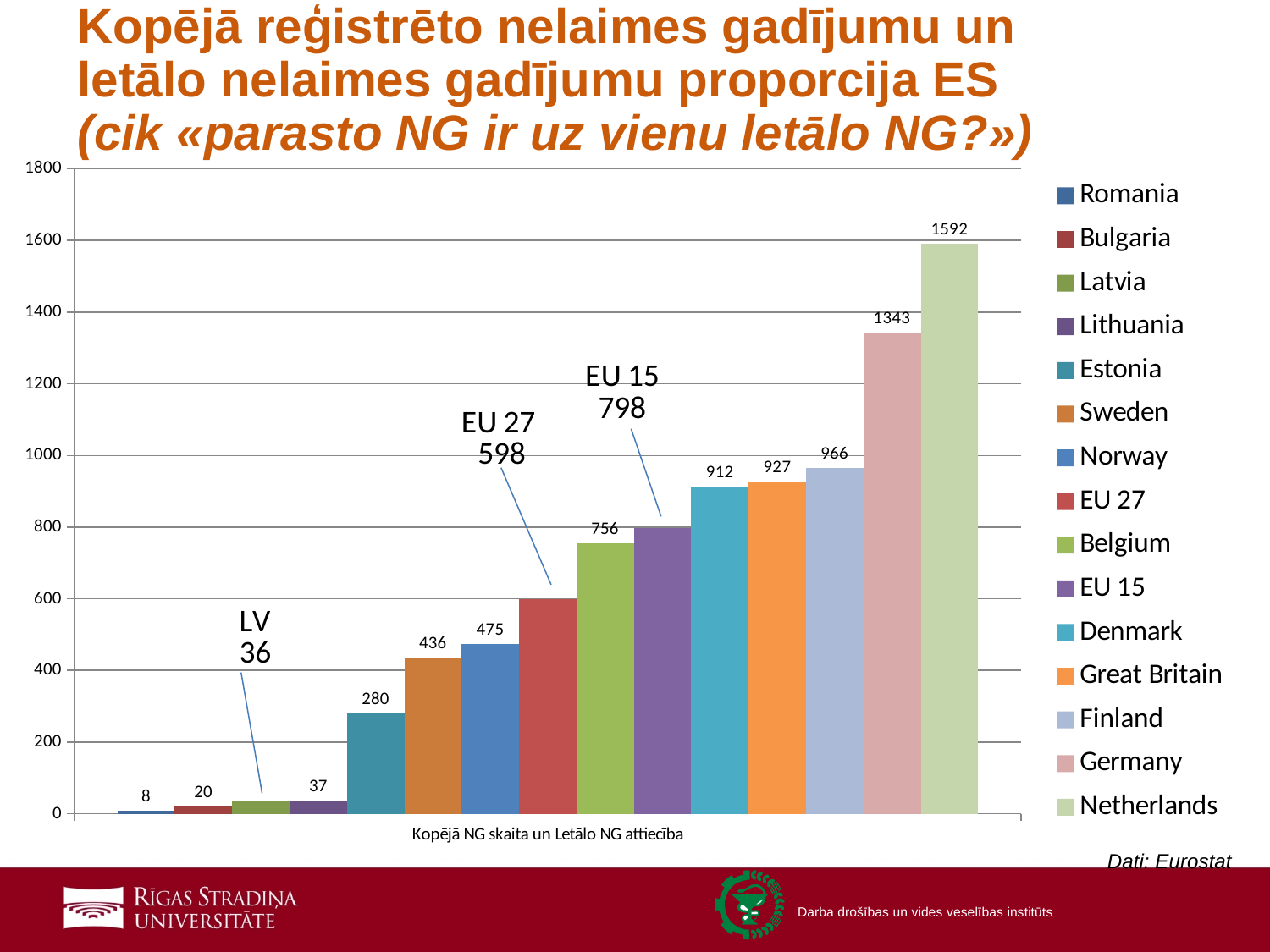
What is the difference between the values for Netherlands and Germany? 249 What kind of chart is shown on the slide? Bar chart Which is larger, the value for Finland or the value for Great Britain? Finland What value is annotated for EU 27? 598 Do the bar values rise or fall from left to right along the x axis? Rise What is the value for Netherlands? 1592 What value is annotated for EU 15? 798 How many series does the legend list? 15 Which country has the lowest value in the chart? Romania What is the value for Germany? 1343 Which country has the highest value in the chart? Netherlands What is the value for Estonia? 280